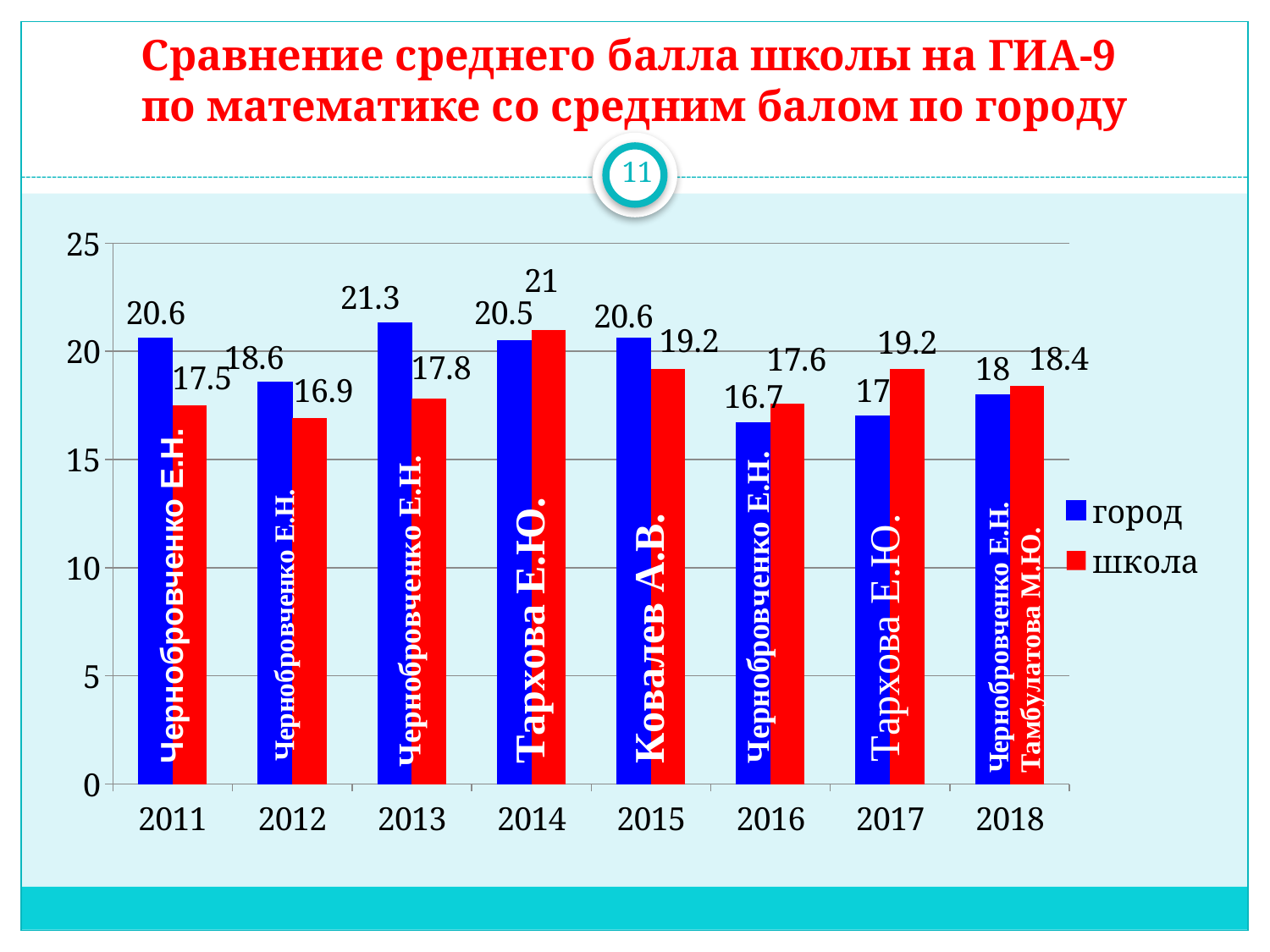
How many series does the legend list? 2 In which year is the город value the highest? 2013 What is the value for город in 2013? 21.3 Which is larger in 2015, город or школа? город Which colour represents the школа series? red Which is larger in 2017, город or школа? школа What is the difference between the город and школа values in 2011? 3.1 How many years are shown on the x axis? 8 What is the value for школа in 2014? 21 What is the value for школа in 2012? 16.9 What kind of chart is shown on the slide? bar chart In which year is the школа value the lowest? 2012